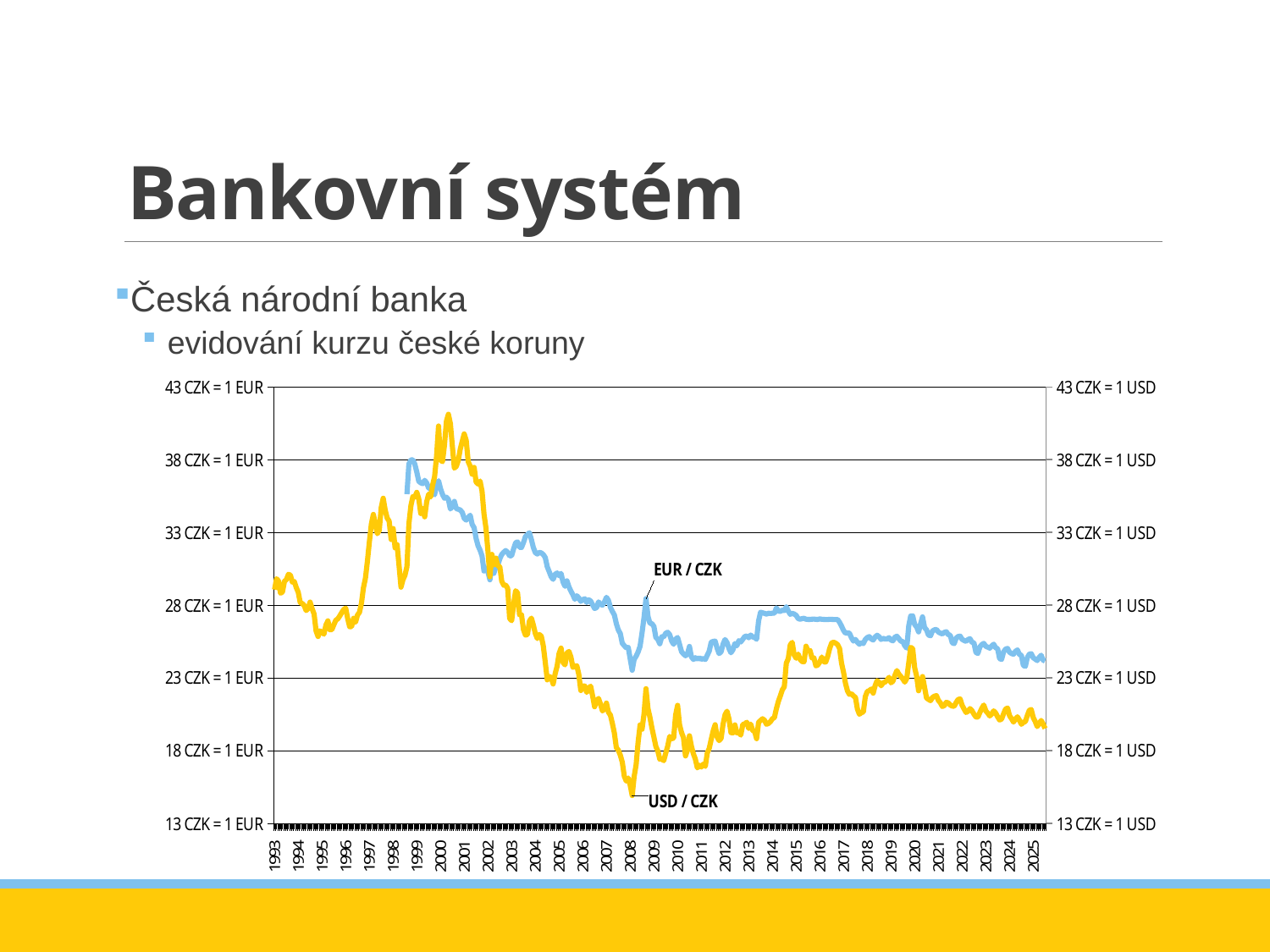
Is the value of EUR / CZK in 2025 greater or less than 28 CZK? less How many years are labelled on the x axis, from 1993 to 2025? 33 Is the value of USD / CZK in 2025 greater or less than 23 CZK? less Which colour is used for the USD / CZK line? yellow Is the value of USD / CZK in 2008 greater or less than 18 CZK? less In 2008, which series has the higher value, EUR / CZK or USD / CZK? EUR / CZK Which series reaches the highest value anywhere on the chart? USD / CZK Does the EUR / CZK line rise or fall between 2020 and 2025? fall How many series are plotted on the chart? 2 What are the two series labelled on the chart? EUR / CZK and USD / CZK What kind of chart is shown on the slide? line chart